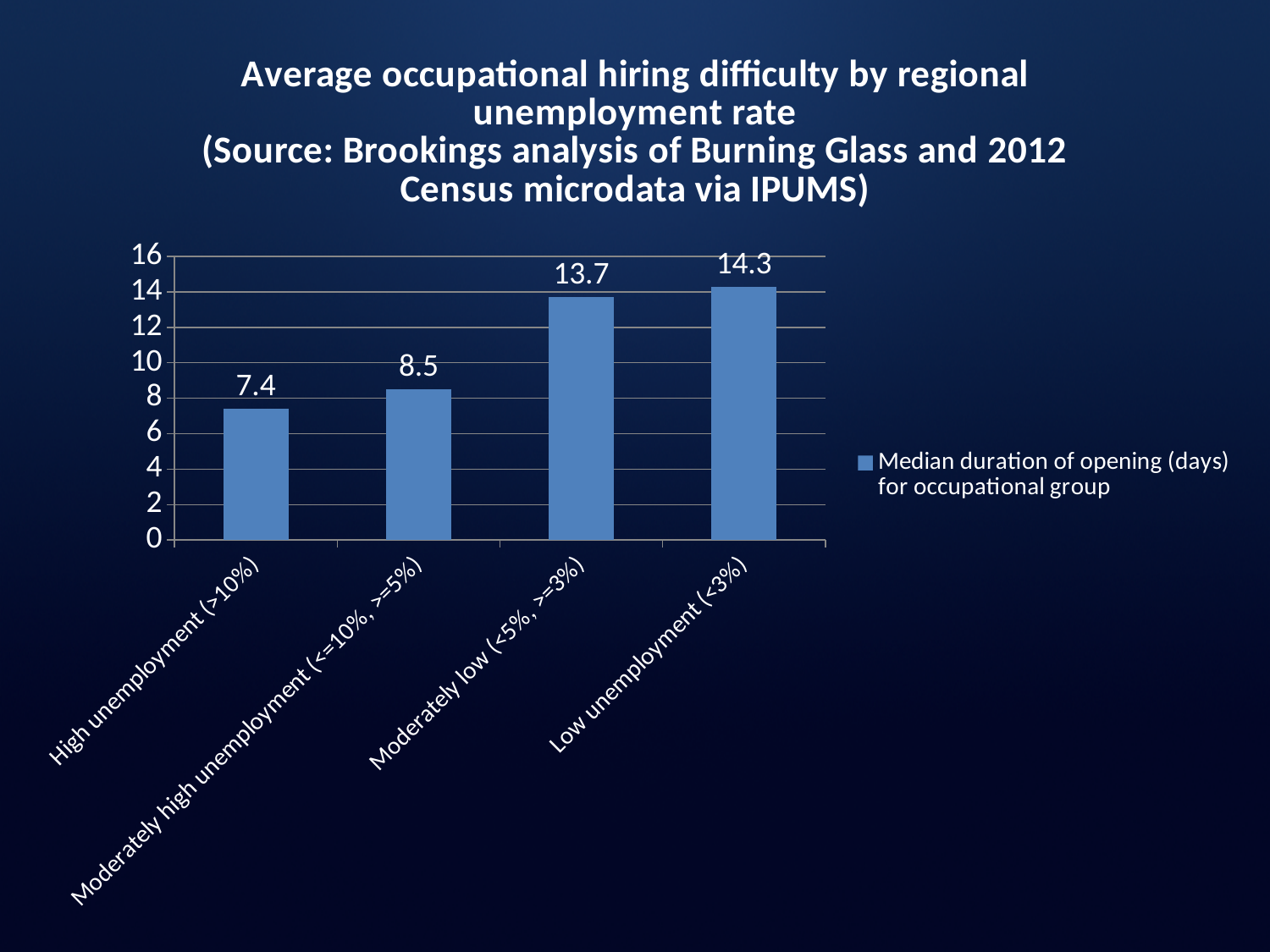
How many series does the legend list? 1 What is the median duration of opening (days) for the Low unemployment (<3%) category? 14.3 Do the values rise or fall moving from High unemployment to Low unemployment along the x axis? Rise How many categories are shown on the x axis of the chart? 4 What is the difference in median duration of opening between Low unemployment (<3%) and High unemployment (>10%)? 6.9 Which category has the lowest median duration of opening? High unemployment (>10%) Which category has the highest median duration of opening? Low unemployment (<3%) What is the median duration of opening (days) for the Moderately low (<5%, >=3%) category? 13.7 Which has a larger median duration of opening: Moderately high unemployment (<=10%, >=5%) or Moderately low (<5%, >=3%)? Moderately low (<5%, >=3%) What is the median duration of opening (days) for the Moderately high unemployment (<=10%, >=5%) category? 8.5 What is the median duration of opening (days) for the High unemployment (>10%) category? 7.4 What kind of chart is shown on the slide? Bar chart